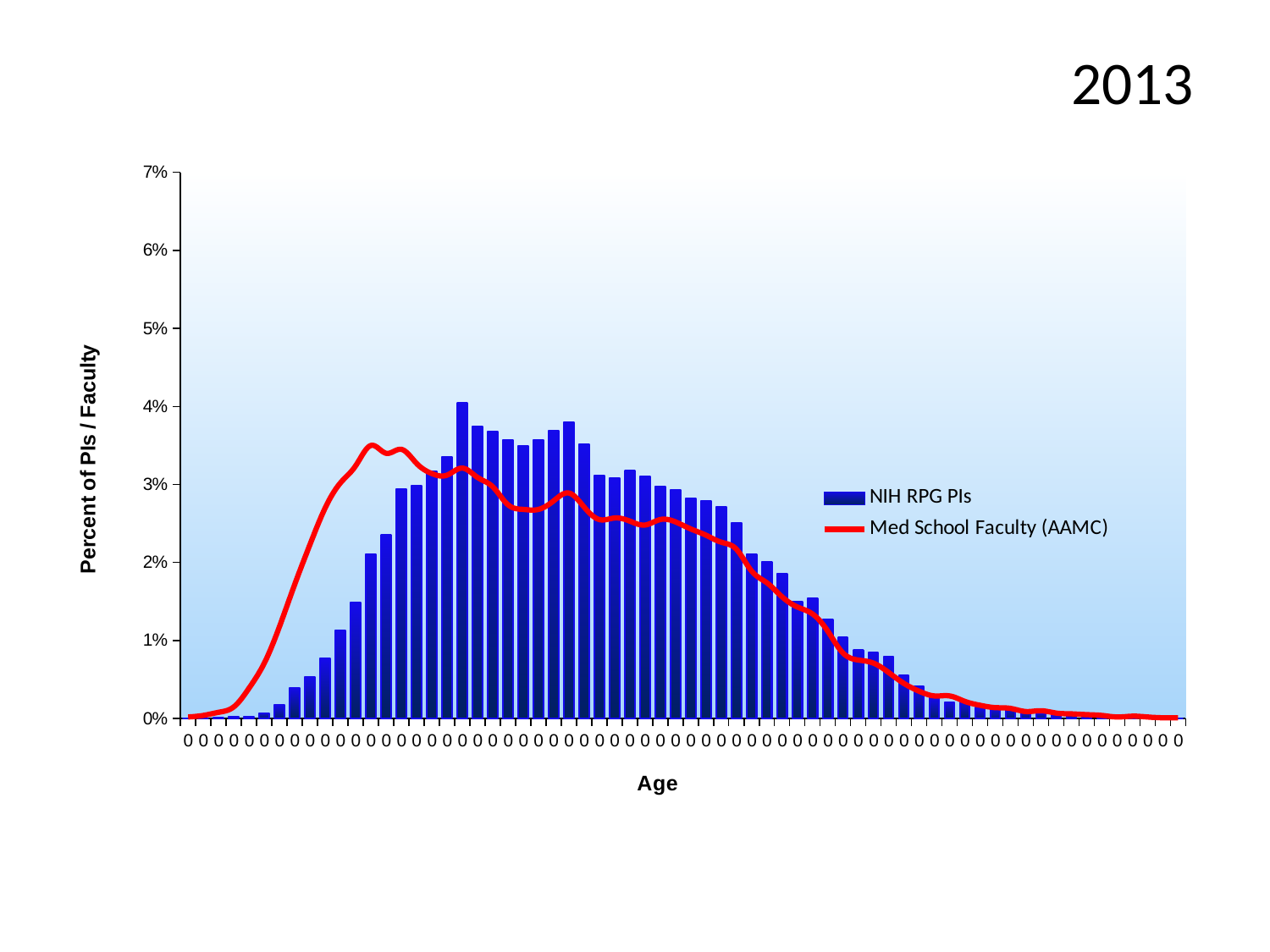
Over the right half of the x axis, do the NIH RPG PIs bars rise or fall? fall Is the highest value of the NIH RPG PIs bars greater or less than 3%? greater Which series reaches the higher peak value, NIH RPG PIs or Med School Faculty (AAMC)? NIH RPG PIs What is the title of the y axis? Percent of PIs / Faculty Is the peak of the Med School Faculty (AAMC) line greater or less than 4%? less What kind of chart is shown on the slide? bar chart with a line overlay How many series does the legend list? 2 Is the peak of the Med School Faculty (AAMC) line greater or less than 3%? greater Over the right half of the x axis, does the Med School Faculty (AAMC) line rise or fall? fall What year is shown as the slide title? 2013